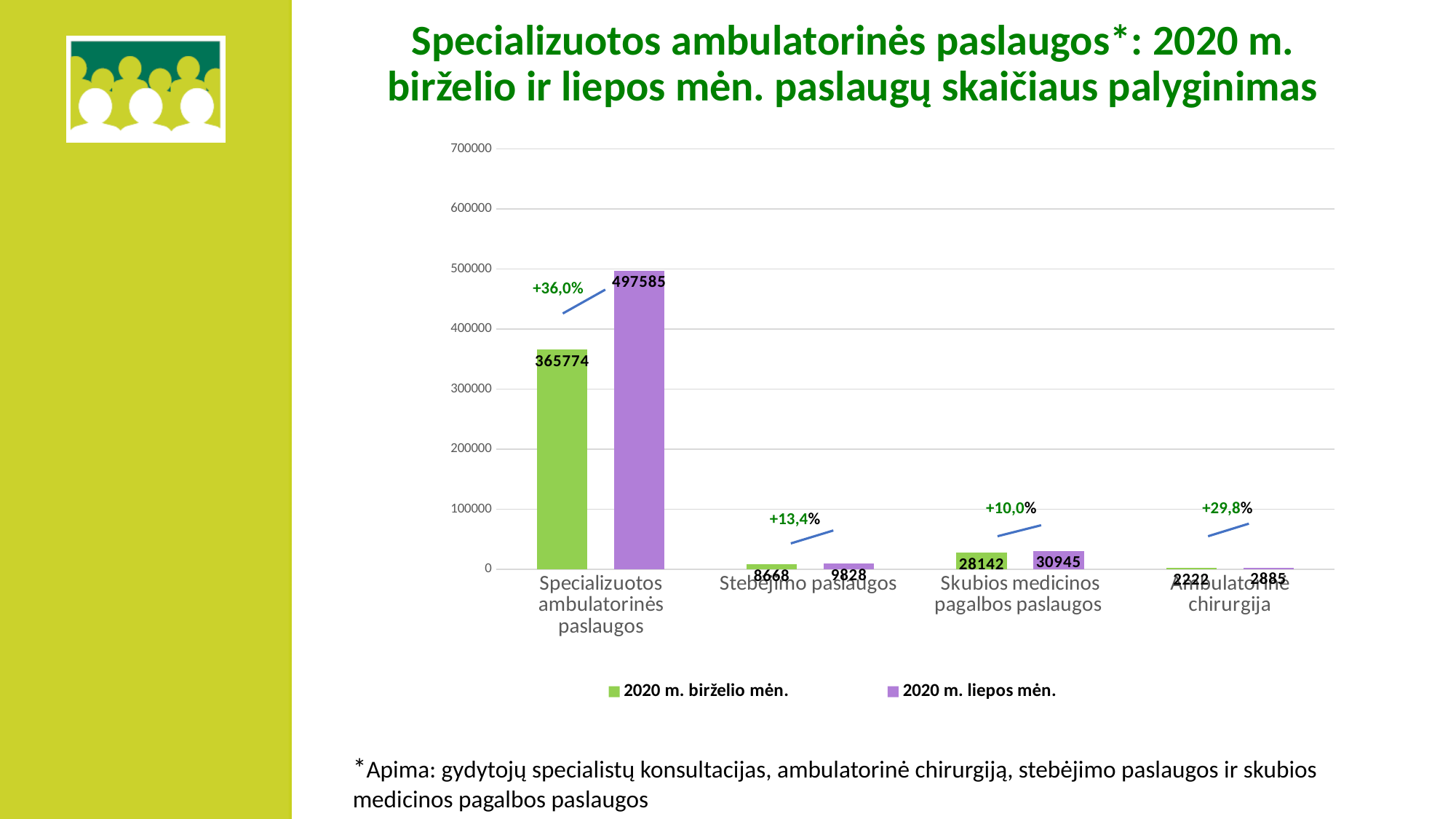
Which is larger for Stebėjimo paslaugos: the 2020 m. birželio mėn. value or the 2020 m. liepos mėn. value? 2020 m. liepos mėn. What percentage change is annotated above the bars for Ambulatorinė chirurgija? +29,8% How many categories are shown on the x axis? 4 What is the value for Specializuotos ambulatorinės paslaugos in 2020 m. birželio mėn.? 365774 How many series does the legend list? 2 What kind of chart is shown on the slide? bar chart What is the value for Specializuotos ambulatorinės paslaugos in 2020 m. liepos mėn.? 497585 What is the value for Stebėjimo paslaugos in 2020 m. birželio mėn.? 8668 What is the value for Skubios medicinos pagalbos paslaugos in 2020 m. liepos mėn.? 30945 Which category has the highest value in 2020 m. liepos mėn.? Specializuotos ambulatorinės paslaugos What is the difference between the 2020 m. liepos mėn. and 2020 m. birželio mėn. values for Skubios medicinos pagalbos paslaugos? 2803 Which category has the lowest value in 2020 m. birželio mėn.? Ambulatorinė chirurgija